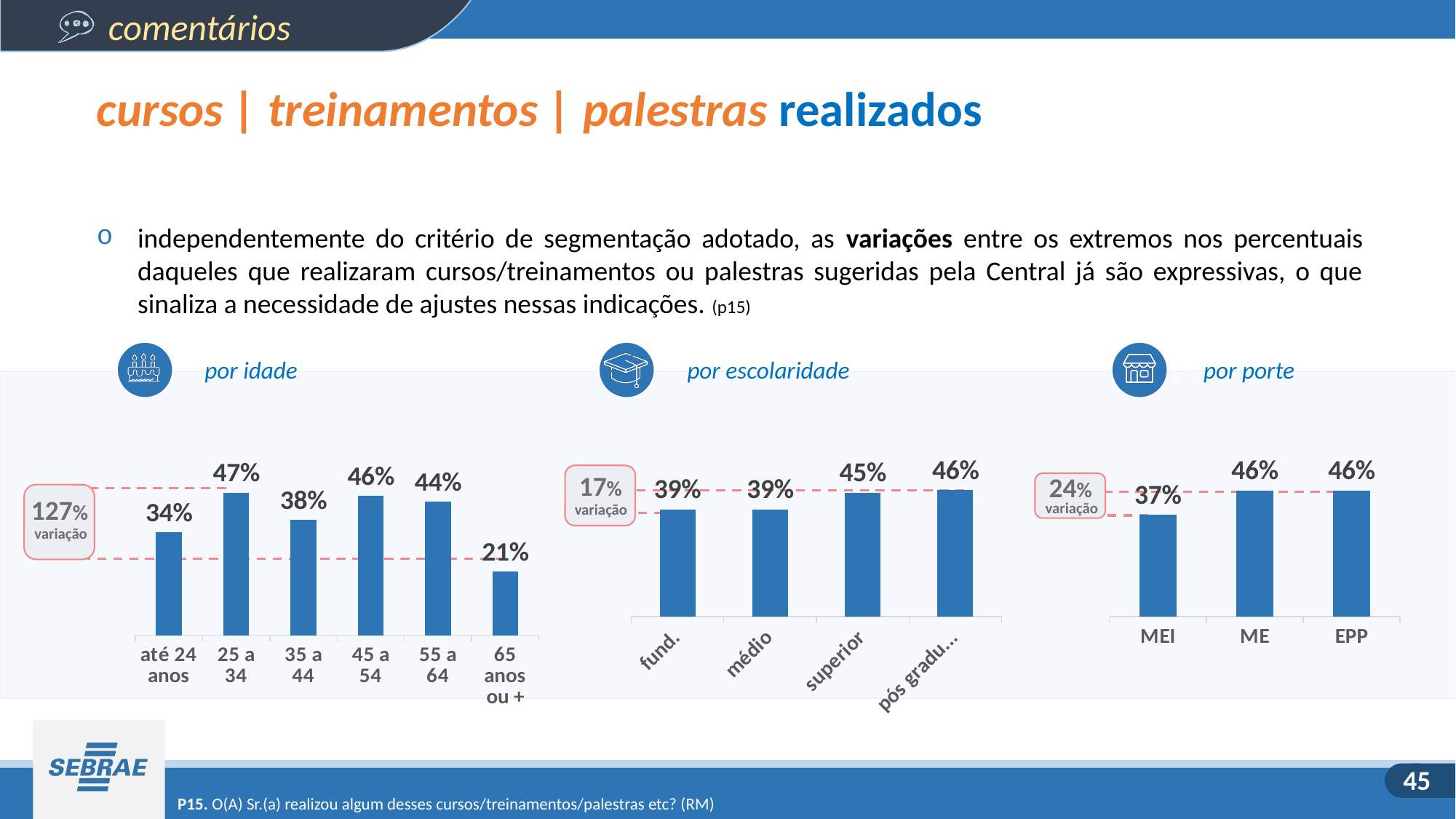
In the 'por idade' chart, what is the difference between the values for '25 a 34' and '65 anos ou +'? 26% In the 'por escolaridade' chart, what is the value for 'fund.'? 39% In the 'por idade' chart, what is the value for '25 a 34'? 47% In the 'por idade' chart, which age group has the highest value? 25 a 34 In the 'por escolaridade' chart, what is the value for 'superior'? 45% What kind of chart is the 'por porte' chart? bar chart In the 'por porte' chart, what is the difference between the values for 'ME' and 'MEI'? 9% In the 'por escolaridade' chart, which is larger, the value for 'médio' or the value for 'superior'? superior What variation percentage is shown in the box next to the 'por idade' chart? 127% In the 'por idade' chart, how many age groups are shown? 6 In the 'por idade' chart, which age group has the lowest value? 65 anos ou + In the 'por porte' chart, what is the value for 'MEI'? 37%